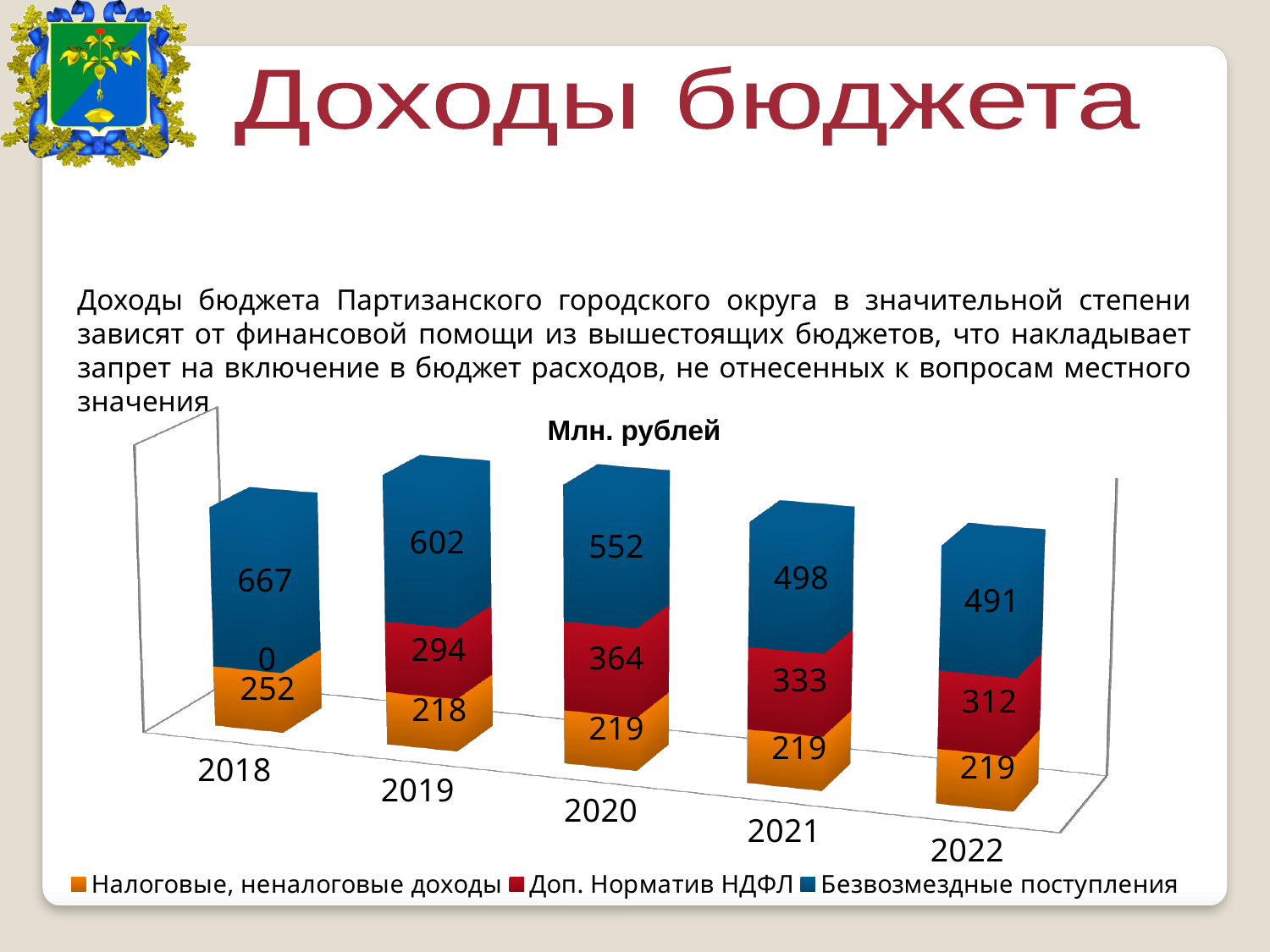
How many years are shown on the x axis of the chart? 5 What is the value of Налоговые, неналоговые доходы for 2019? 218 Which is larger: Доп. Норматив НДФЛ in 2021 or in 2022? 2021 In which year is Безвозмездные поступления the highest? 2018 What is the value of Безвозмездные поступления for 2018? 667 What is the difference between Безвозмездные поступления in 2019 and in 2022? 111 What is the value of Доп. Норматив НДФЛ for 2020? 364 How many series does the chart legend list? 3 In which year is Доп. Норматив НДФЛ the lowest? 2018 What kind of chart is shown on the slide? stacked bar chart What is the total of the stacked bar for 2020? 1135 What is the title of the chart? Млн. рублей